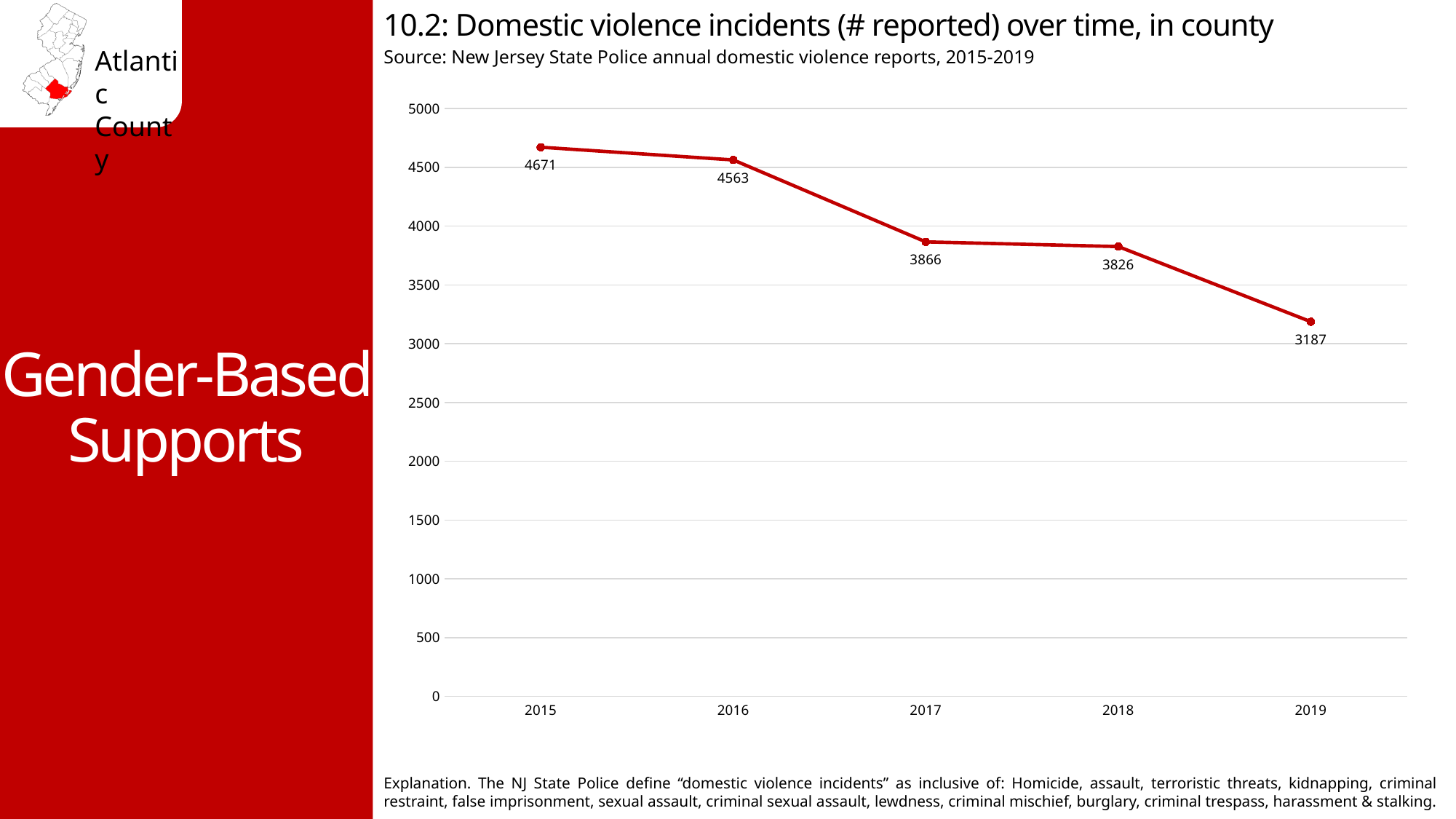
Do the reported domestic violence incidents rise or fall from 2015 to 2019? fall Which year has the lowest number of reported domestic violence incidents? 2019 Is the value for 2019 greater or less than 3500? less What kind of chart is shown on the slide? line chart How many domestic violence incidents were reported in 2015? 4671 What is the difference between the 2017 and 2018 values? 40 Which year has the highest number of reported domestic violence incidents? 2015 How many years are plotted on the chart? 5 What is the number of reported domestic violence incidents for 2019? 3187 Which year had more reported incidents, 2016 or 2018? 2016 What value is shown for 2017? 3866 What is the difference between the number of incidents in 2015 and 2019? 1484